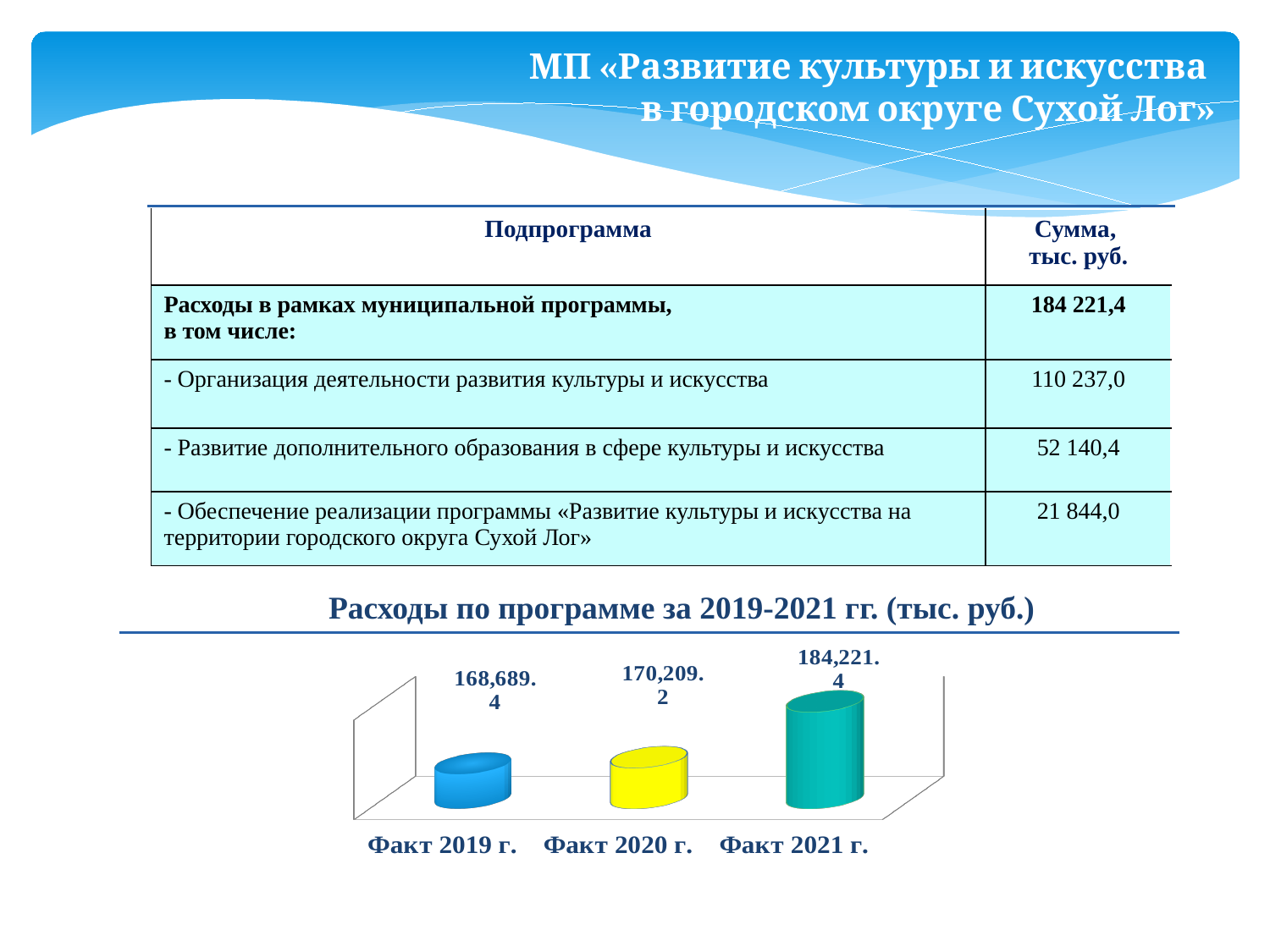
Which category has the highest value? Факт 2021 г. What is the title of the chart? Расходы по программе за 2019-2021 гг. (тыс. руб.) What is the value for Факт 2020 г.? 170,209.2 What is the value for Факт 2021 г.? 184,221.4 Which category has the lowest value? Факт 2019 г. Which is larger, the value for Факт 2020 г. or Факт 2021 г.? Факт 2021 г. What is the value for Факт 2019 г.? 168,689.4 What is the difference between the values for Факт 2021 г. and Факт 2019 г.? 15,532.0 What is the difference between the values for Факт 2021 г. and Факт 2020 г.? 14,012.2 Do the values rise or fall from Факт 2019 г. to Факт 2021 г.? Rise What kind of chart is shown on the slide? Bar chart How many categories are shown in the chart? 3